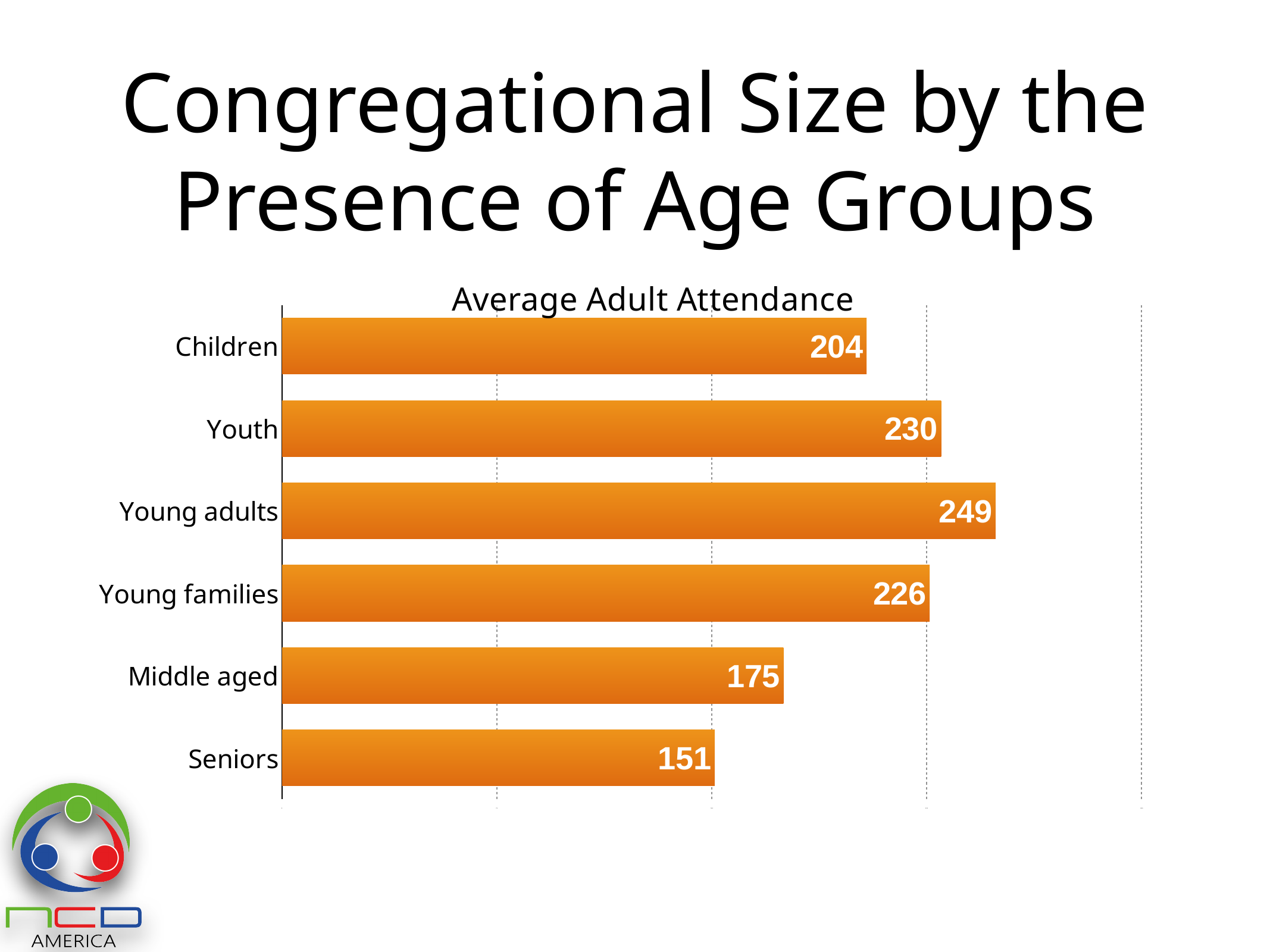
What is the difference in average adult attendance between Youth and Young families? 4 Which has a higher average adult attendance, Children or Middle aged? Children What type of chart is shown on the slide? Bar chart What is the average adult attendance for congregations with Seniors present? 151 What is the average adult attendance for congregations with Young adults present? 249 What is the average adult attendance for congregations with Children present? 204 How many age groups are shown in the chart? 6 Which age group has the lowest average adult attendance? Seniors Which age group has the highest average adult attendance? Young adults What is the title of the chart? Average Adult Attendance What is the difference in average adult attendance between Young adults and Seniors? 98 What is the average adult attendance for congregations with Middle aged people present? 175